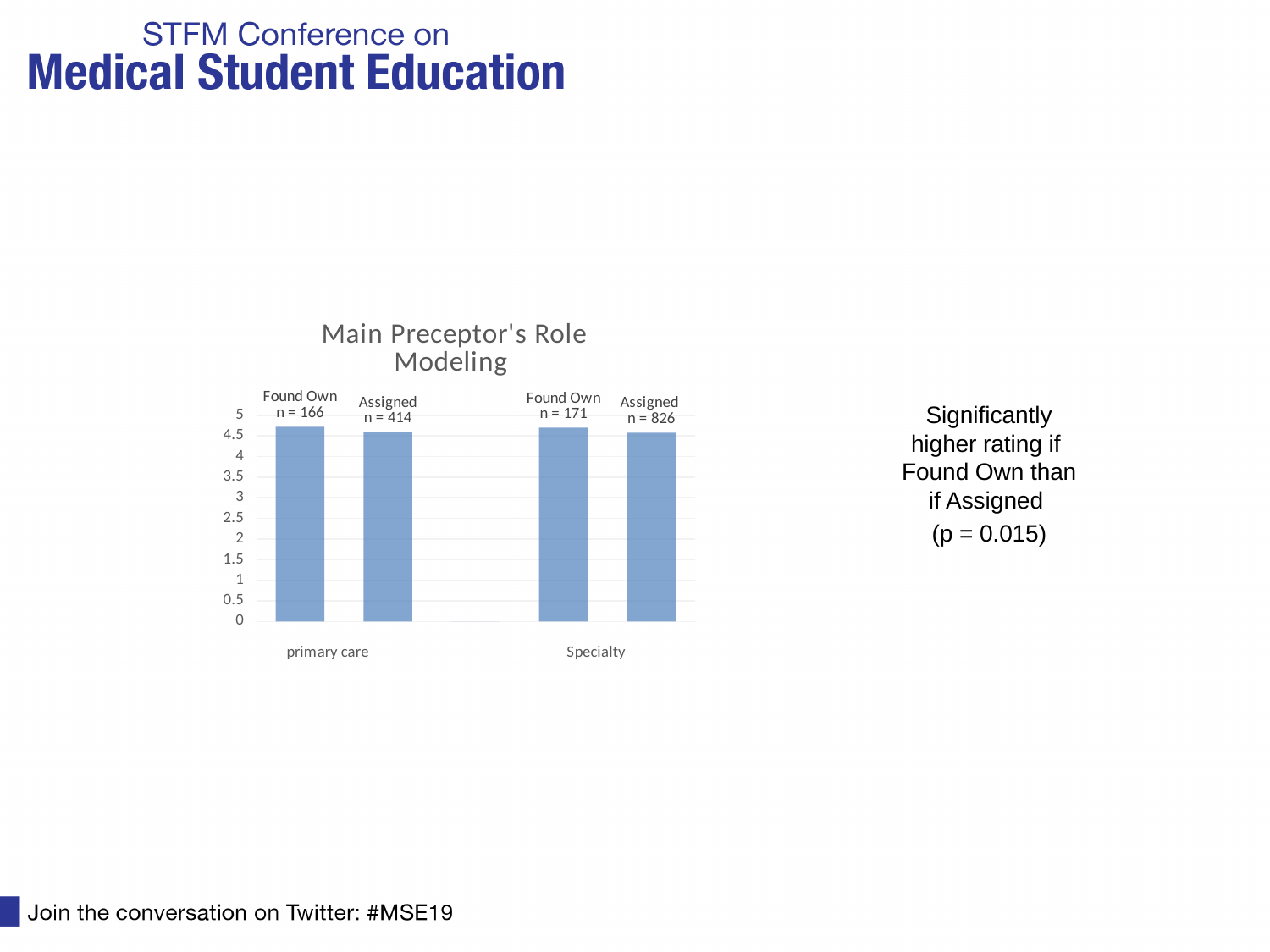
What is the title of the chart? Main Preceptor's Role Modeling Is the value for Assigned in Specialty greater or less than 4? greater What is the highest value shown on the y axis of the chart? 5 Is the value for Found Own in primary care greater or less than 4? greater What is the n shown for the Found Own bar in primary care? n = 166 How many bars are plotted in the chart? 4 What is the n shown for the Assigned bar in Specialty? n = 826 What kind of chart is shown on the slide? bar chart How many category groups are labelled along the x axis of the chart? 2 In primary care, which bar is taller: Found Own or Assigned? Found Own Is the value for Found Own in Specialty greater or less than 5? less